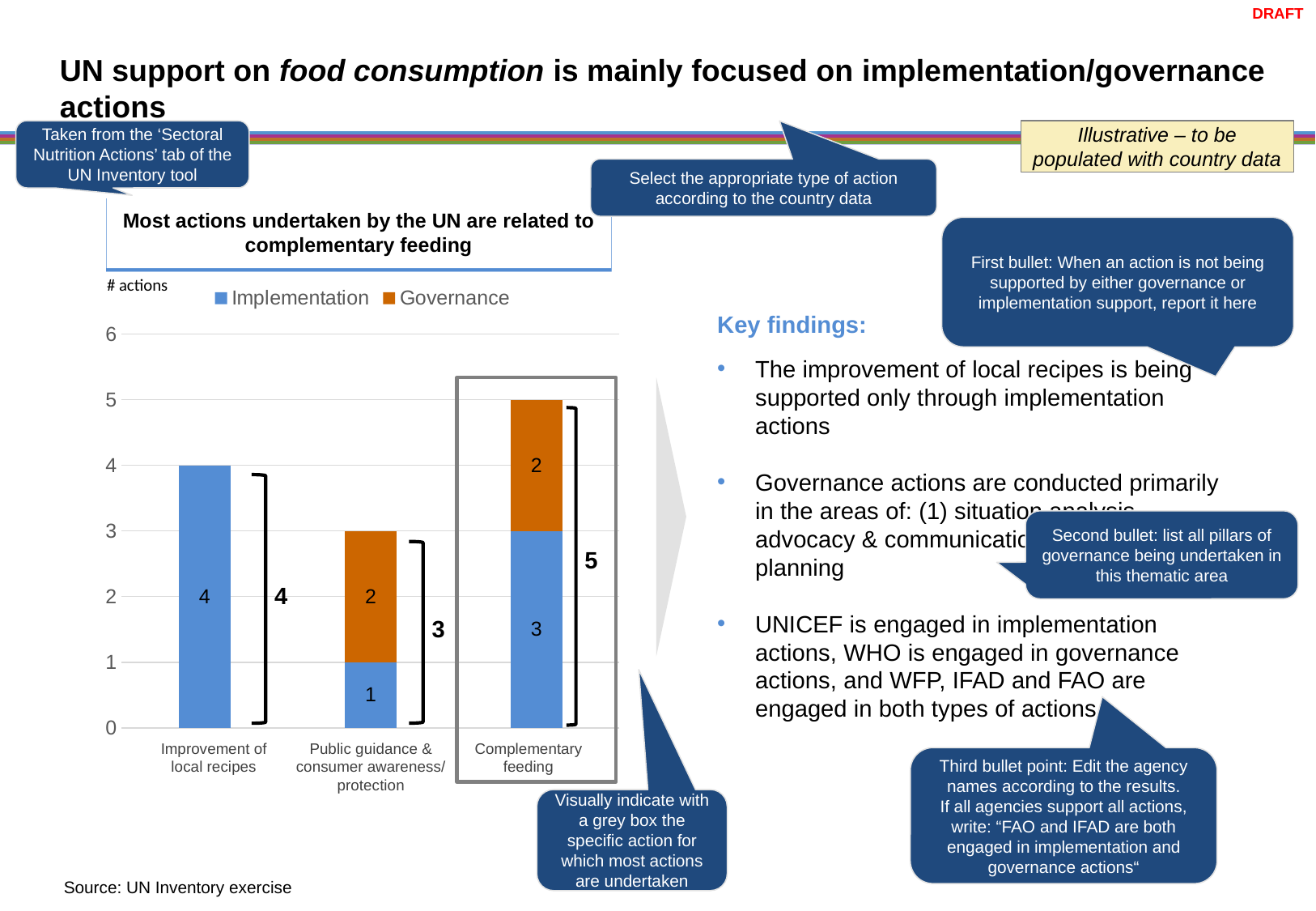
What is the difference between the total actions for Complementary feeding and Improvement of local recipes? 1 Which is larger: the Implementation value for Improvement of local recipes or the Implementation value for Complementary feeding? Improvement of local recipes What is the Governance value for Complementary feeding? 2 How many series does the legend list? 2 Which category has the highest total number of actions? Complementary feeding What type of chart is shown on the slide? Stacked bar chart What is the total number of actions for Public guidance & consumer awareness/protection? 3 What is the total number of actions for Complementary feeding? 5 Which category has the lowest total number of actions? Public guidance & consumer awareness/protection What is the Implementation value for Improvement of local recipes? 4 What is the Implementation value for Complementary feeding? 3 What is the Governance value for Public guidance & consumer awareness/protection? 2